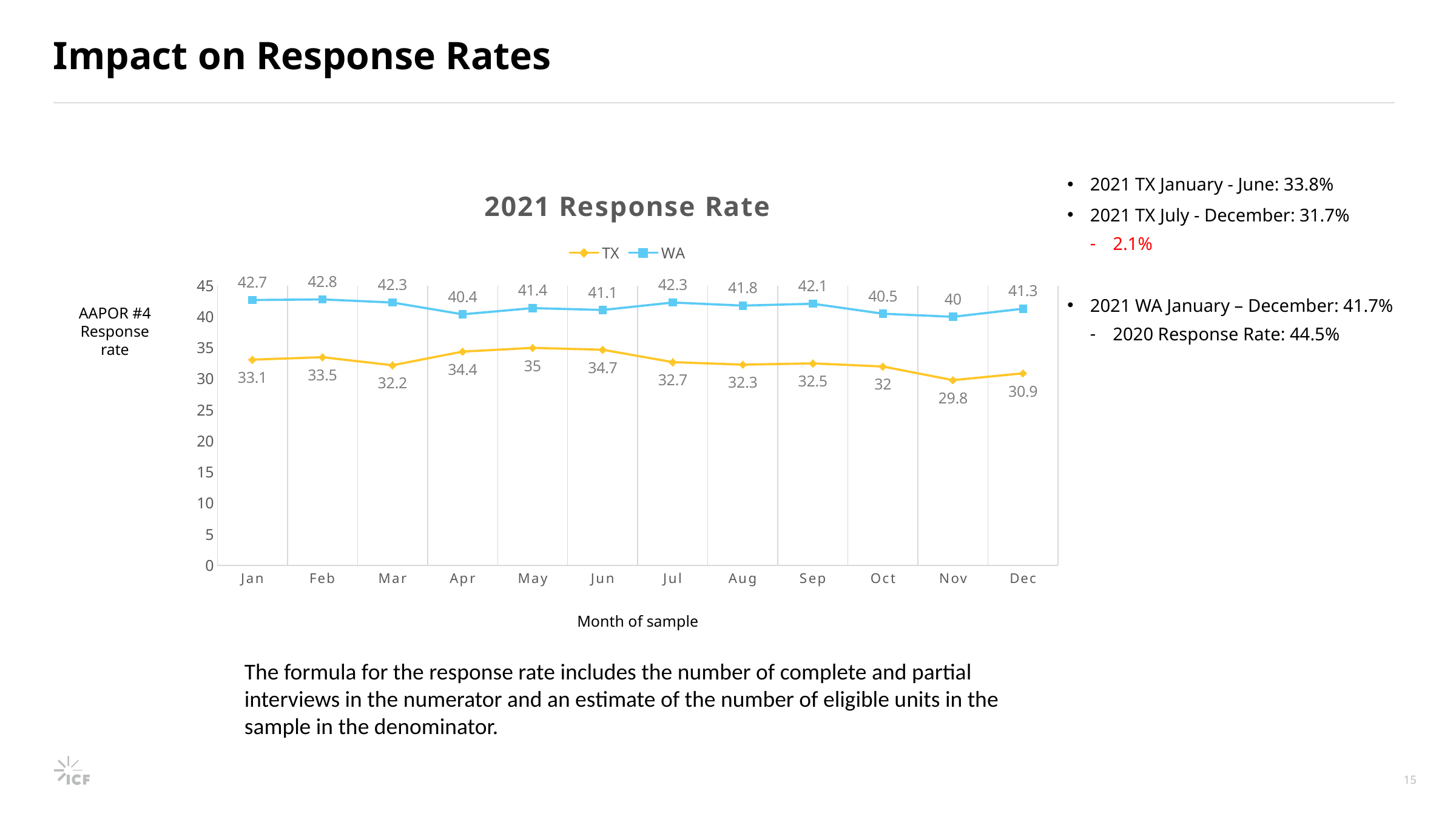
How many series does the legend list? 2 Does the TX response rate rise or fall from Jun to Nov? Fall How many months are shown on the x axis? 12 In which month is the WA response rate highest? Feb What is the title of the chart? 2021 Response Rate What is the TX response rate for May? 35 What is the TX response rate for Dec? 30.9 What is the difference between the WA and TX response rates in Jan? 9.6 What is the WA response rate for Nov? 40 In which month is the TX response rate lowest? Nov Which series has the higher response rate in Jul, TX or WA? WA What kind of chart is shown? Line chart